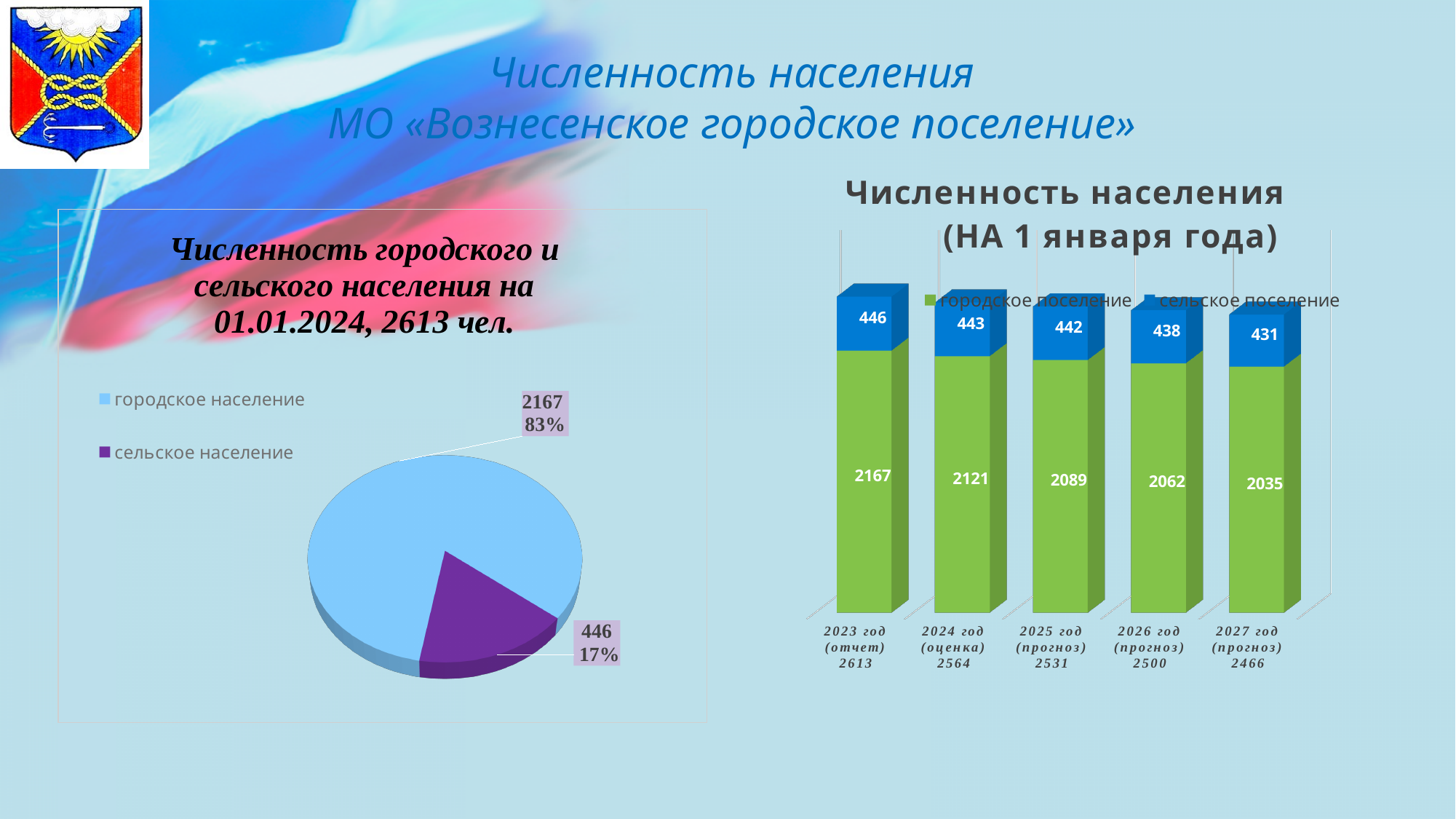
In the bar chart on the right, what is the difference between the городское поселение values for 2023 год (отчет) and 2024 год (оценка)? 46 In the bar chart on the right, do the values for городское поселение rise or fall from 2023 to 2027? fall What kind of chart is the chart on the left of the slide? pie chart How many series does the legend of the bar chart on the right list? 2 In the bar chart on the right, what is the total of the stacked bar for 2026 год (прогноз)? 2500 In the bar chart on the right, what is the value for сельское поселение in 2027 год (прогноз)? 431 In the bar chart on the right, how many years are shown on the x axis? 5 In the bar chart on the right, which year has the lowest value for городское поселение? 2027 год (прогноз) In the pie chart on the left, what is the value for городское население? 2167 In the pie chart on the left, what share of the pie does сельское население take? 17% In the bar chart on the right, what is the value for городское поселение in 2025 год (прогноз)? 2089 In the pie chart on the left, how many slices are there? 2